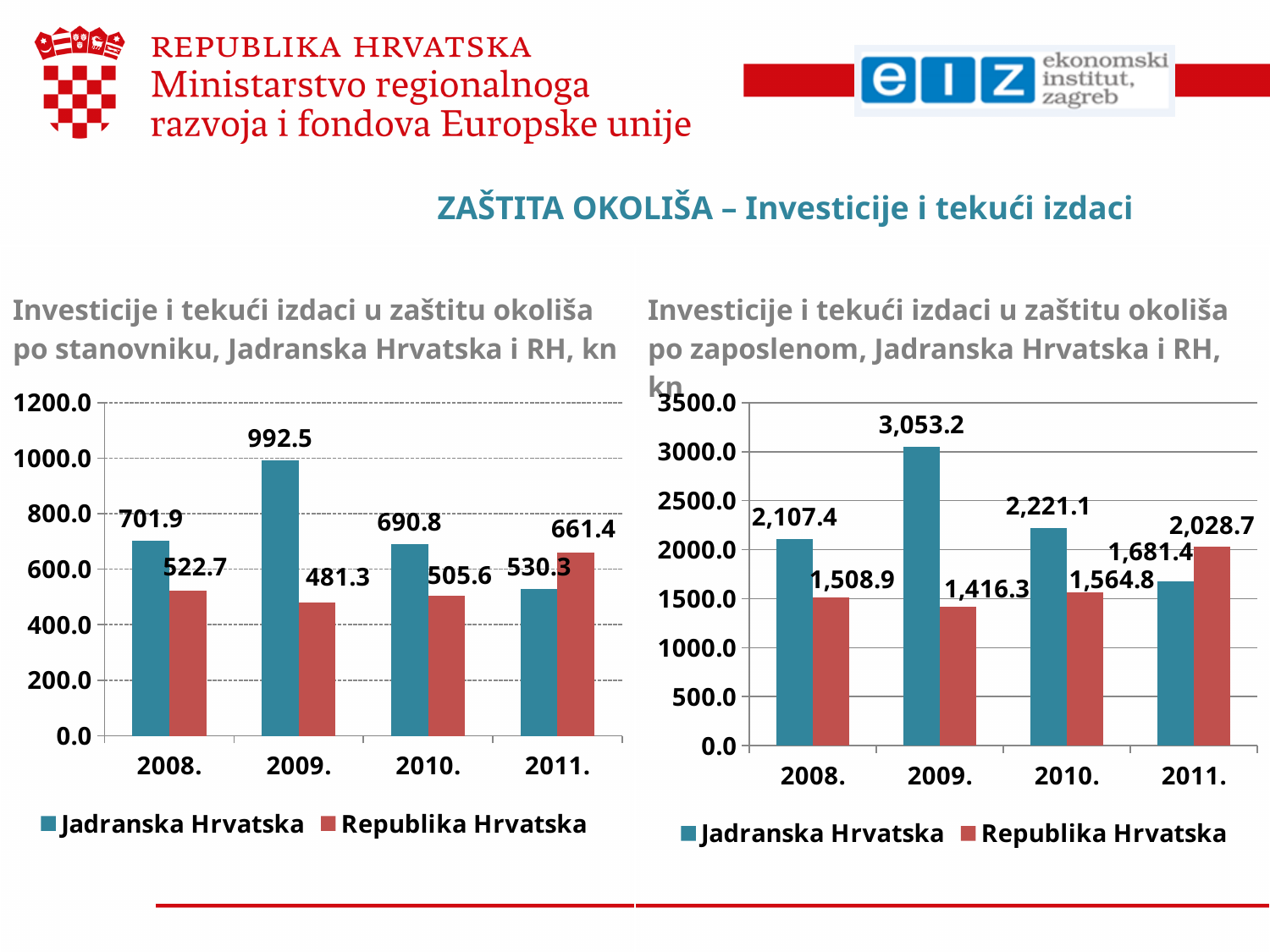
In the right chart (po zaposlenom), which year has the highest value for Jadranska Hrvatska? 2009. How many series does the legend of the left chart (po stanovniku) list? 2 How many years are shown on the x axis of the right chart (po zaposlenom)? 4 In the right chart (po zaposlenom), what is the difference between Republika Hrvatska and Jadranska Hrvatska in 2011.? 347.3 In the left chart (po stanovniku), what is the difference between Jadranska Hrvatska and Republika Hrvatska in 2009.? 511.2 In the right chart (po zaposlenom), what is the value for Republika Hrvatska in 2008.? 1,508.9 In the left chart (po stanovniku), what is the value for Jadranska Hrvatska in 2009.? 992.5 In the left chart (po stanovniku), which year has the lowest value for Republika Hrvatska? 2009. In the left chart (po stanovniku), which is larger in 2011., Jadranska Hrvatska or Republika Hrvatska? Republika Hrvatska What type of chart is the right chart (po zaposlenom)? Bar chart In the right chart (po zaposlenom), what is the value for Jadranska Hrvatska in 2010.? 2,221.1 In the left chart (po stanovniku), what is the value for Republika Hrvatska in 2011.? 661.4